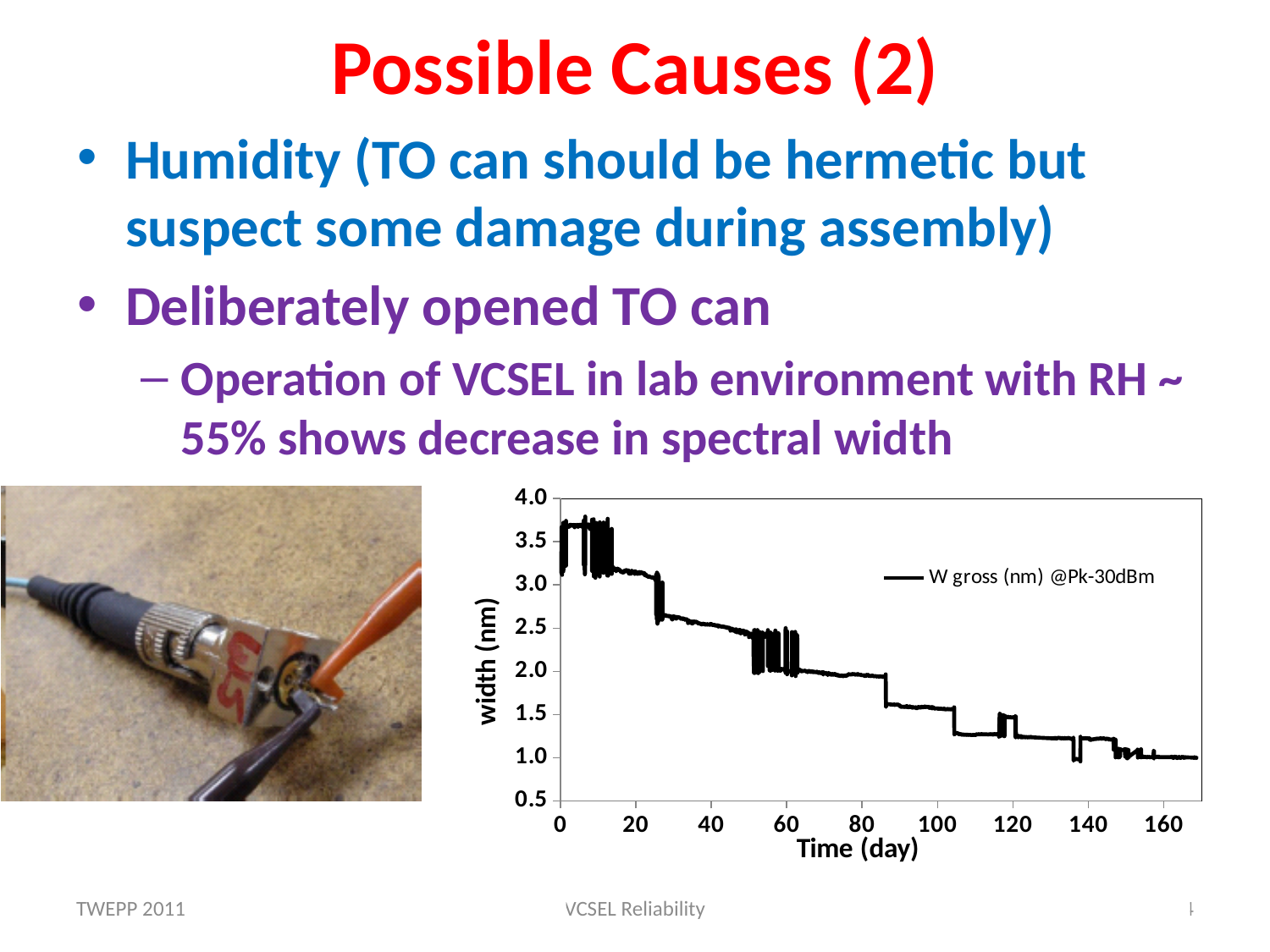
Which is larger, the width value at day 20 or the width value at day 120? day 20 What kind of chart is shown on the slide? line chart Is the width value at day 20 greater or less than 2.5? greater What is the legend entry for the series plotted in the chart? W gross (nm) @Pk-30dBm Is the width value at day 40 greater or less than 2.0? greater How many series does the chart's legend list? 1 Is the width value at day 160 greater or less than 1.5? less What is the label of the x axis of the chart? Time (day) Do the plotted width values rise or fall as time increases along the x axis? fall